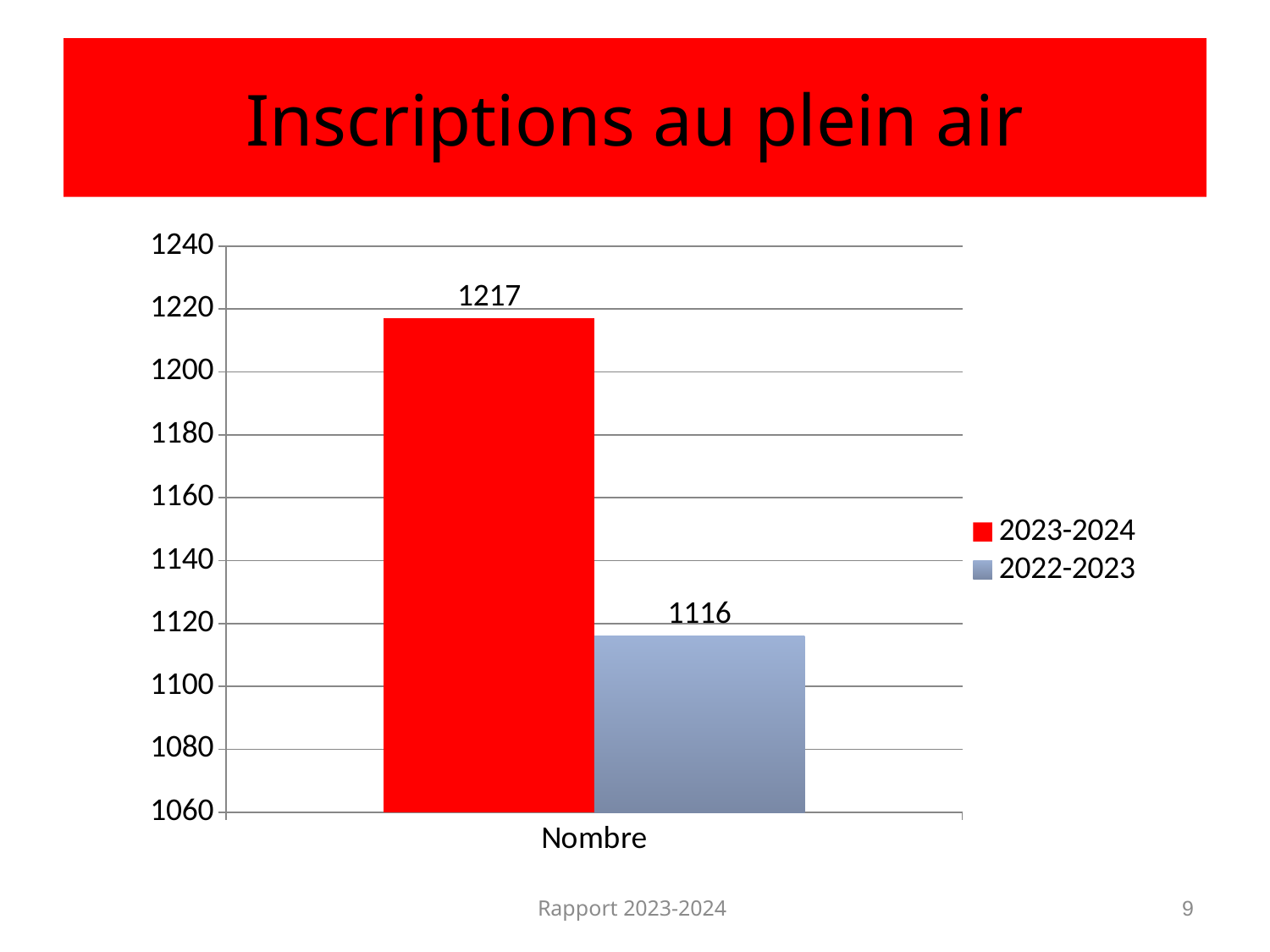
What is the value for 2022-2023 in the chart? 1116 What is the total of the two values shown in the chart? 2333 Is the value for 2022-2023 greater or less than 1120? less What is the category label shown on the x axis? Nombre How many series does the legend list? 2 What is the value for 2023-2024 in the chart? 1217 What colour is the bar for 2023-2024? red Which series has the lowest value in the chart? 2022-2023 What kind of chart is shown on the slide? bar chart What is the difference between the 2023-2024 value and the 2022-2023 value? 101 Which series has the higher value, 2023-2024 or 2022-2023? 2023-2024 Is the value for 2023-2024 greater or less than 1200? greater